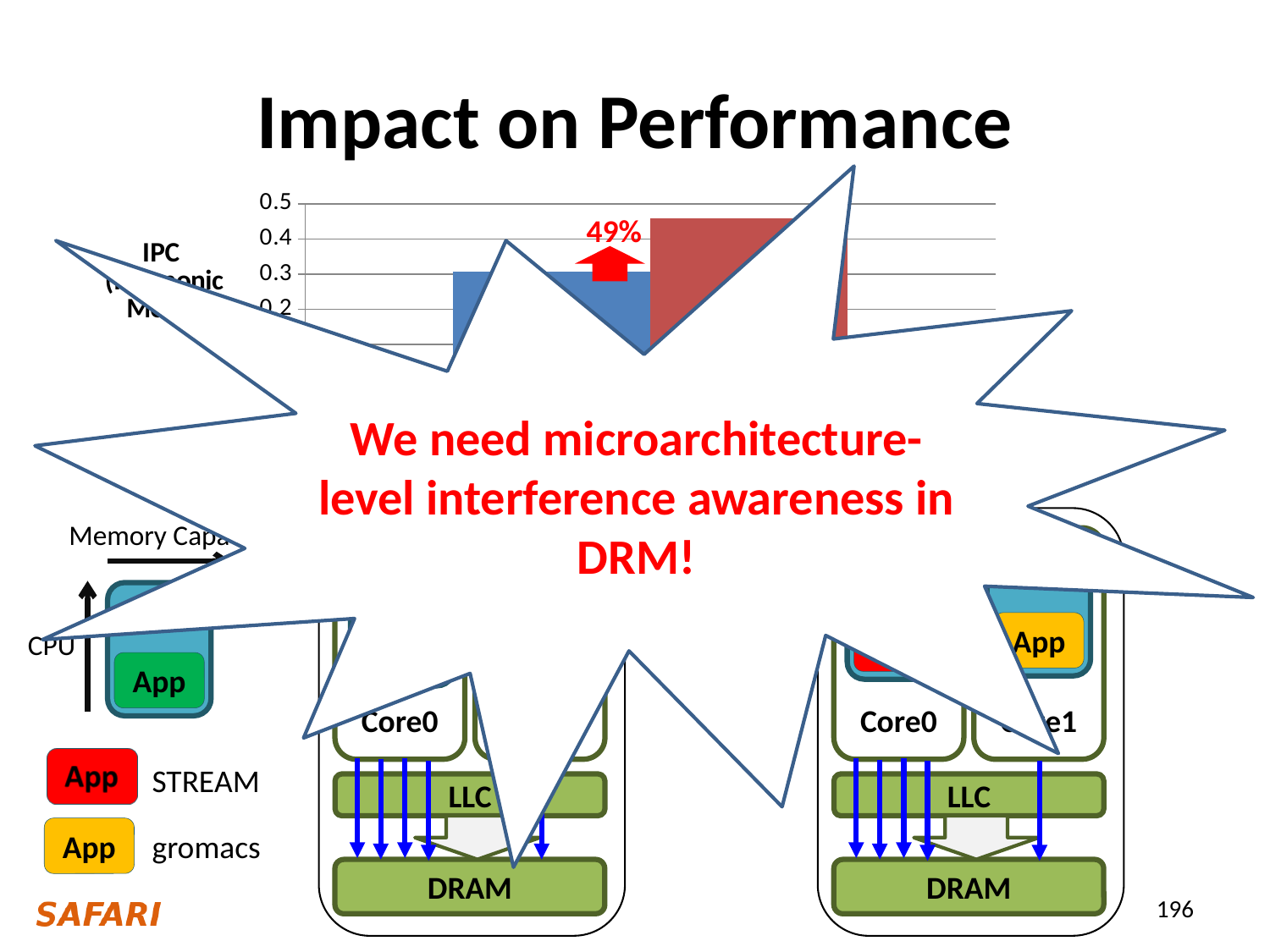
Is the value of the leftmost blue bar in the chart greater or less than 0.4? less What is the highest value labelled on the chart's vertical axis? 0.5 Is the value of the red bar in the chart greater or less than 0.4? greater What kind of chart is shown at the top of the slide? bar chart Is the value of the red bar in the chart greater or less than 0.3? greater Which is larger in the chart, the red bar or the blue bar immediately to its left? the red bar What percentage improvement is annotated above the bars in the chart? 49%